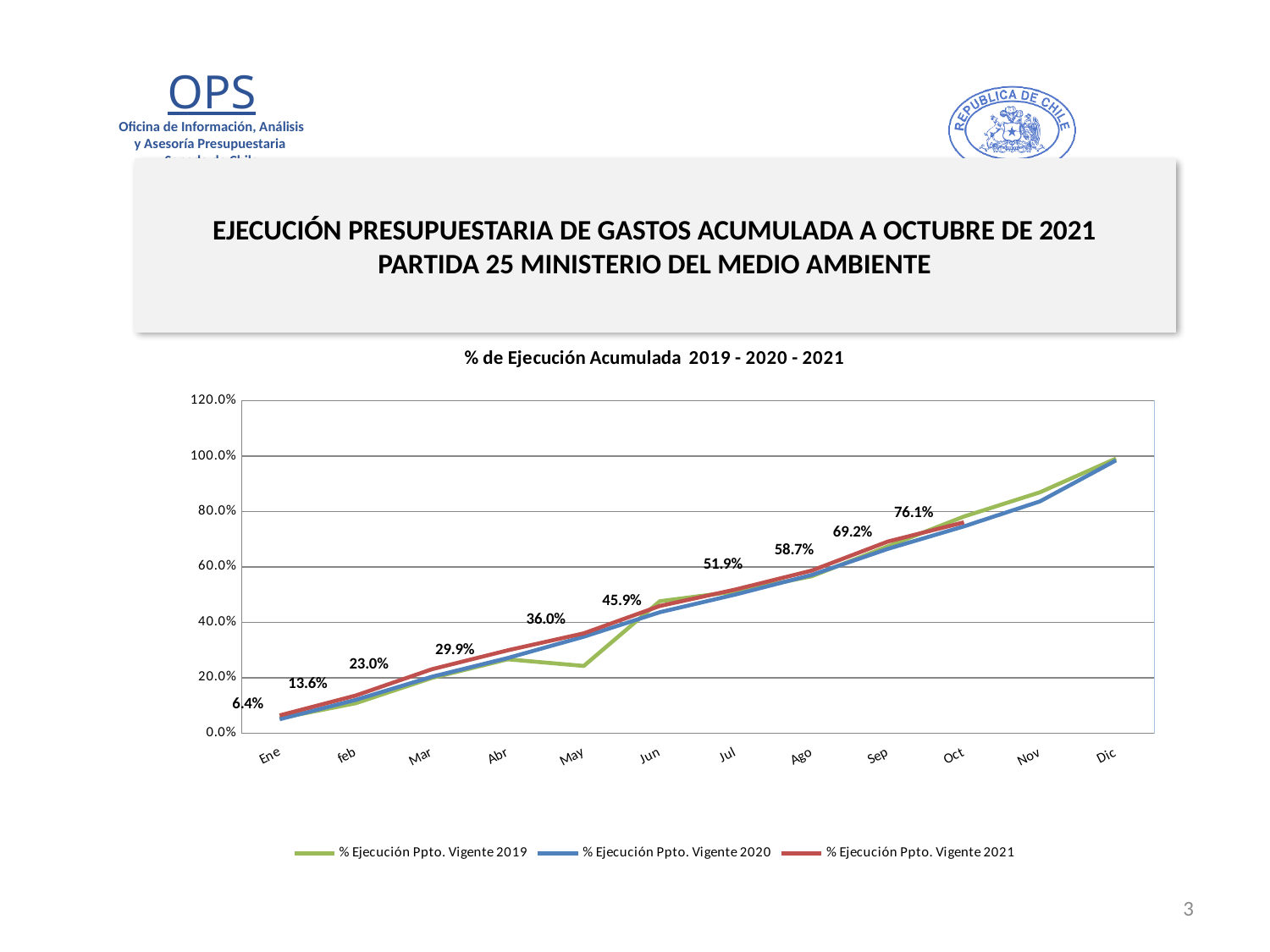
What is the value for % Ejecución Ppto. Vigente 2021 in May? 36.0% How many series does the legend list? 3 How many months are shown on the x axis? 12 What is the difference between the 2021 values for Jun and Ene? 39.5% What is the difference between the 2021 values for Oct and Sep? 6.9% What is the value for % Ejecución Ppto. Vigente 2021 in Oct? 76.1% Do the values for % Ejecución Ppto. Vigente 2021 rise or fall from Ene to Oct? rise What type of chart is shown on the slide? line chart What is the value for % Ejecución Ppto. Vigente 2021 in Ago? 58.7% Among the labeled 2021 values, which month has the highest value? Oct Is the value for % Ejecución Ppto. Vigente 2019 in May greater or less than 40.0%? less What is the value for % Ejecución Ppto. Vigente 2021 in Ene? 6.4%